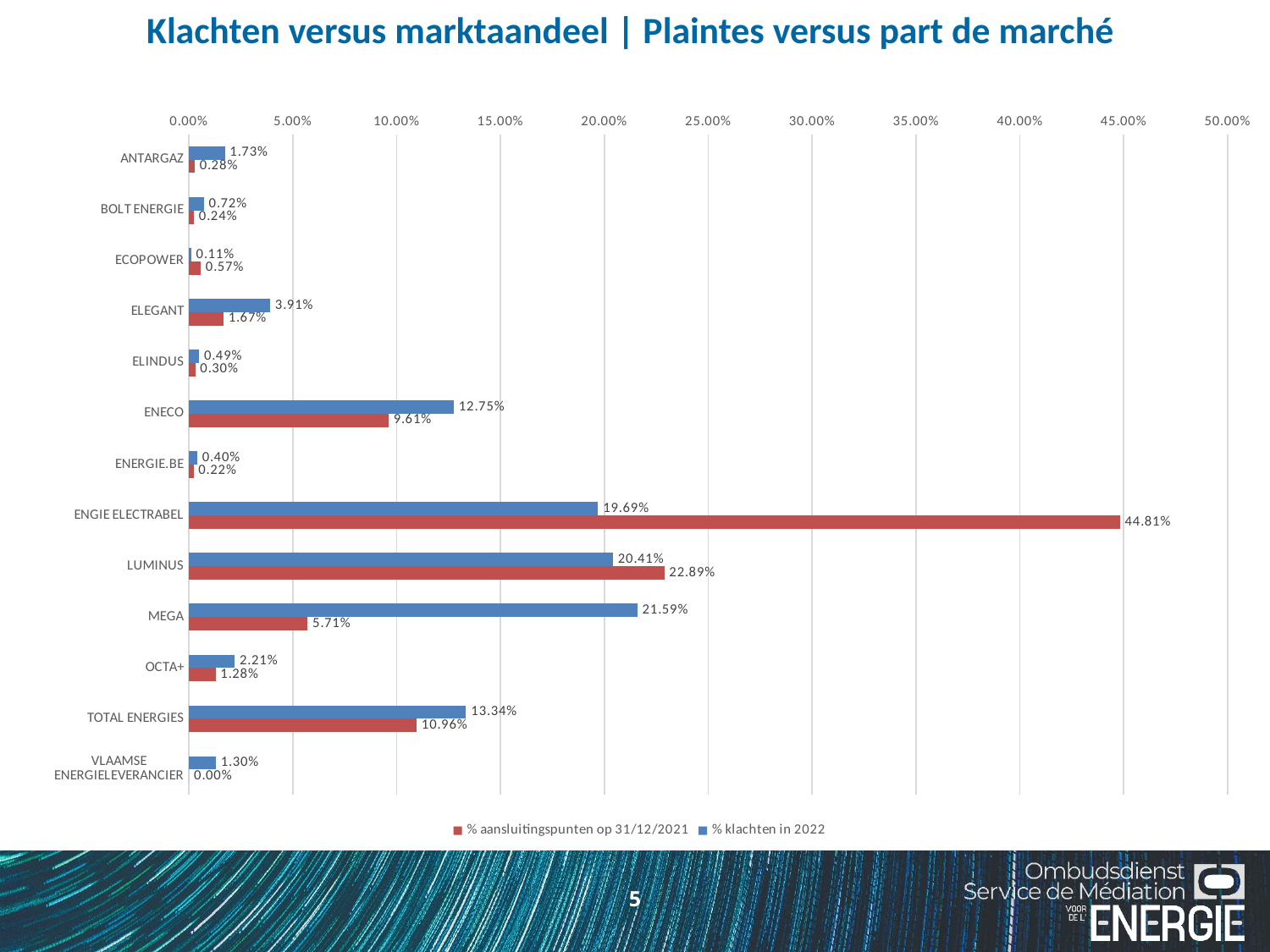
Which category has the lowest value for % klachten in 2022? ECOPOWER What kind of chart is shown on the slide? Bar chart How many categories (suppliers) are shown on the chart? 13 Which category has the highest value for % aansluitingspunten op 31/12/2021? ENGIE ELECTRABEL What is the value of % aansluitingspunten op 31/12/2021 for ENGIE ELECTRABEL? 44.81% How many series does the legend list? 2 What is the value of % aansluitingspunten op 31/12/2021 for ENECO? 9.61% What is the title of the chart? Klachten versus marktaandeel | Plaintes versus part de marché What is the value of % klachten in 2022 for MEGA? 21.59% For MEGA, which is larger: % klachten in 2022 or % aansluitingspunten op 31/12/2021? % klachten in 2022 Is the value of % aansluitingspunten op 31/12/2021 for LUMINUS greater or less than 20.00%? greater What is the difference between % aansluitingspunten op 31/12/2021 and % klachten in 2022 for ENGIE ELECTRABEL? 25.12%